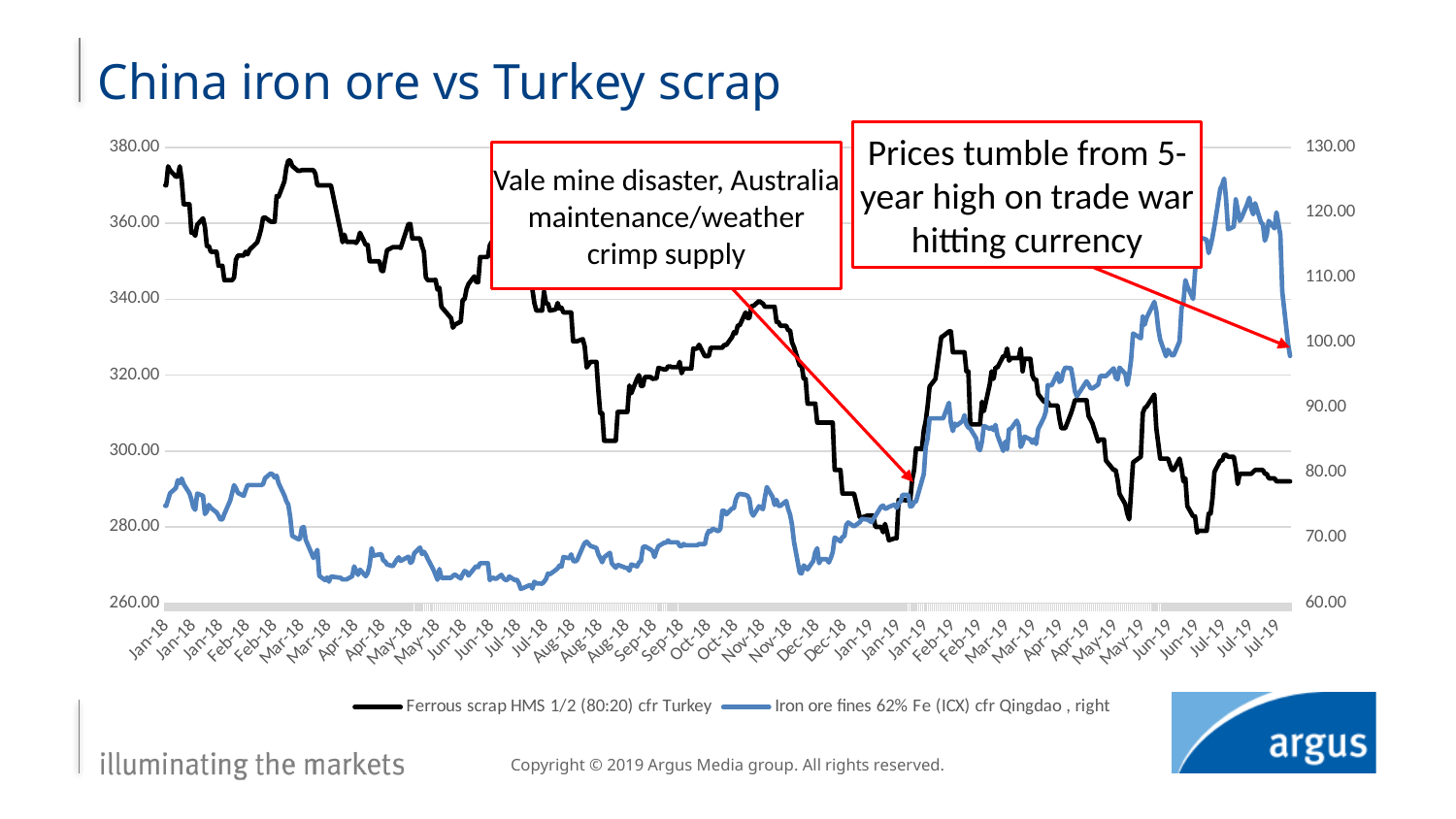
Is the value of the Ferrous scrap HMS 1/2 (80:20) cfr Turkey series at the start of Jan-18 greater or less than 360? greater What kind of chart is shown on the slide? line chart How many series does the legend list? 2 Does the Iron ore fines 62% Fe (ICX) cfr Qingdao series generally rise or fall between Jan-19 and Jul-19? rise Is the value of the Iron ore fines 62% Fe (ICX) cfr Qingdao series at the start of Jan-18 greater or less than 80 on the right axis? less What is the highest tick value shown on the left-hand axis? 380.00 Which series is plotted against the right-hand axis? Iron ore fines 62% Fe (ICX) cfr Qingdao What is the title of the chart? China iron ore vs Turkey scrap Is the lowest value of the Iron ore fines 62% Fe (ICX) cfr Qingdao series around Jul-18 greater or less than 70 on the right axis? less Does the Ferrous scrap HMS 1/2 (80:20) cfr Turkey series generally rise or fall between Mar-18 and Dec-18? fall